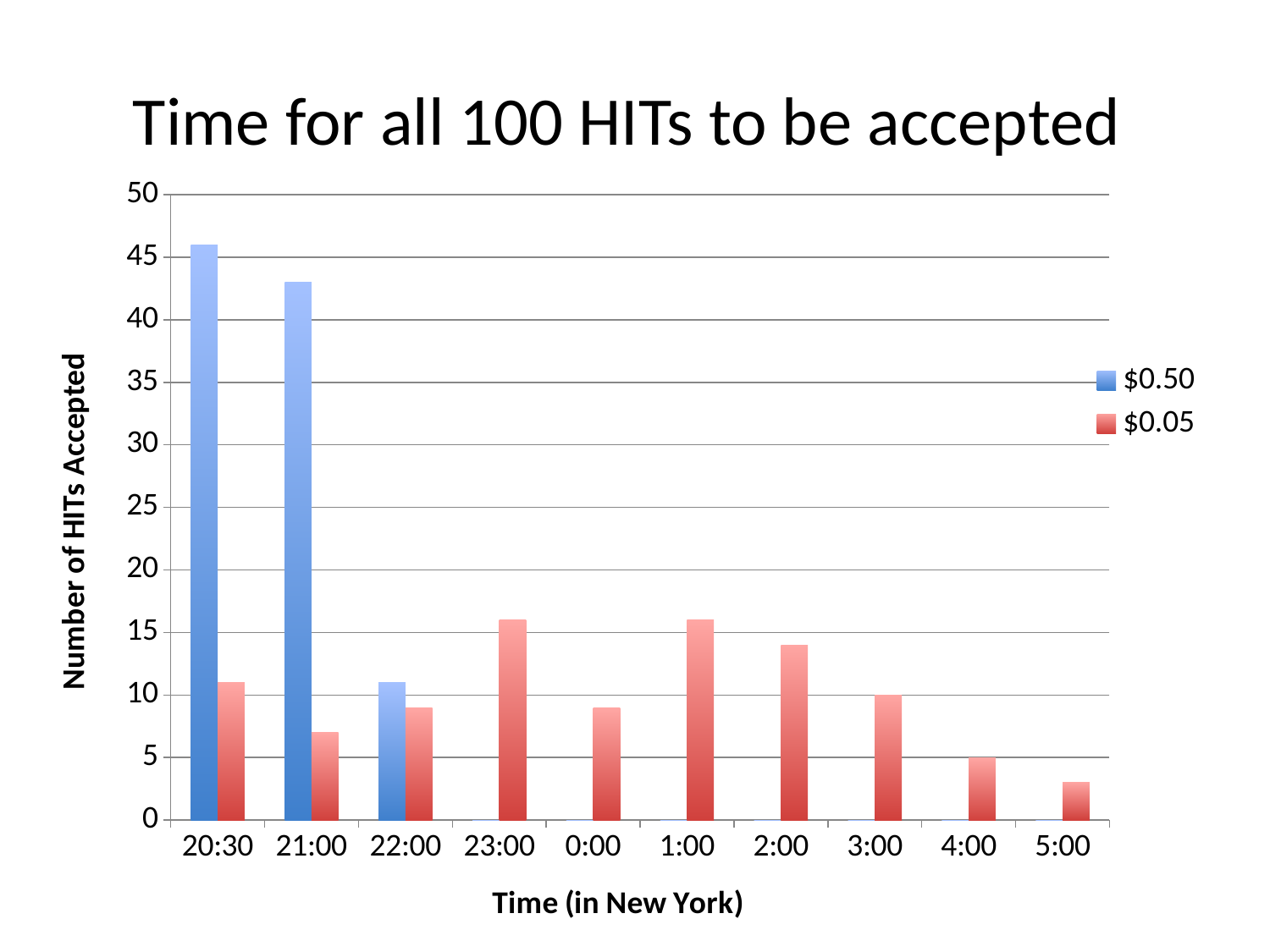
At 20:30, which series has the larger value, $0.50 or $0.05? $0.50 At which time is the $0.05 series lowest? 5:00 Is the value for $0.05 at 5:00 greater or less than 5? less Is the value for $0.05 at 21:00 greater or less than 10? less At which time is the $0.50 series highest? 20:30 How many time categories are shown on the x axis? 10 Is the value for $0.50 at 20:30 greater or less than 40? greater How many series does the legend list? 2 What kind of chart is shown on the slide? bar chart What is the title of the chart? Time for all 100 HITs to be accepted Do the $0.50 values rise or fall from 20:30 to 22:00? fall